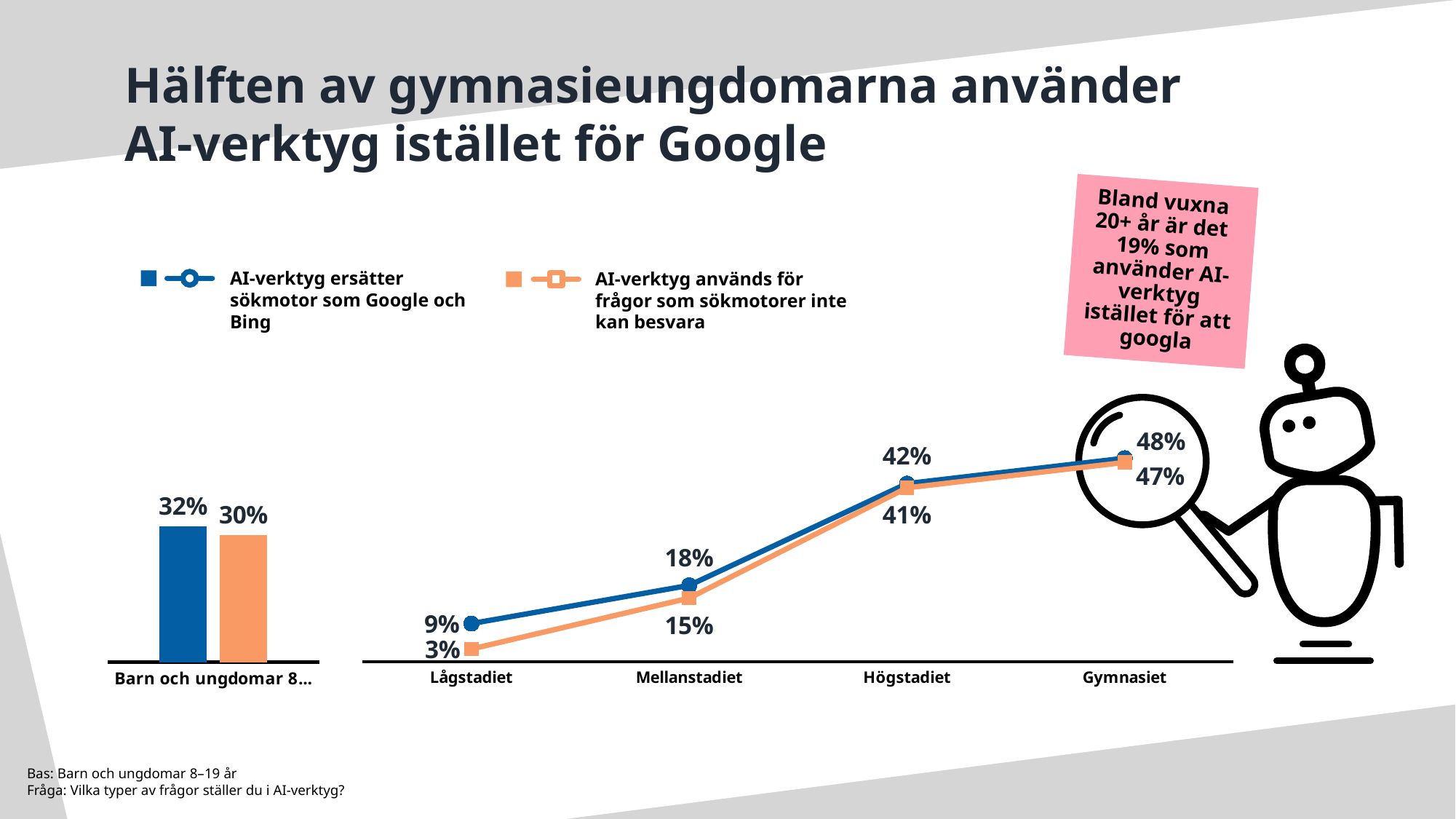
In the line chart on the right, do the values for 'AI-verktyg ersätter sökmotor som Google och Bing' rise or fall from Lågstadiet to Gymnasiet? rise In the bar chart on the left, which bar is larger, the blue one or the orange one? the blue one (32%) In the line chart on the right, which category has the lowest value for the series 'AI-verktyg används för frågor som sökmotorer inte kan besvara'? Lågstadiet In the line chart on the right, what is the value for Högstadiet for the series 'AI-verktyg används för frågor som sökmotorer inte kan besvara'? 41% In the line chart on the right, what is the value for Lågstadiet for the series 'AI-verktyg används för frågor som sökmotorer inte kan besvara'? 3% In the bar chart on the left, what is the value of the blue bar for 'Barn och ungdomar 8...'? 32% In the line chart on the right, what is the value for Gymnasiet for the series 'AI-verktyg ersätter sökmotor som Google och Bing'? 48% How many series does the legend list? 2 In the line chart on the right, how many categories are shown on the x axis? 4 In the line chart on the right, what is the difference between the two series' values for Lågstadiet? 6 percentage points In the line chart on the right, what is the value for Mellanstadiet for the series 'AI-verktyg ersätter sökmotor som Google och Bing'? 18% In the line chart on the right, which category has the highest value for the series 'AI-verktyg ersätter sökmotor som Google och Bing'? Gymnasiet